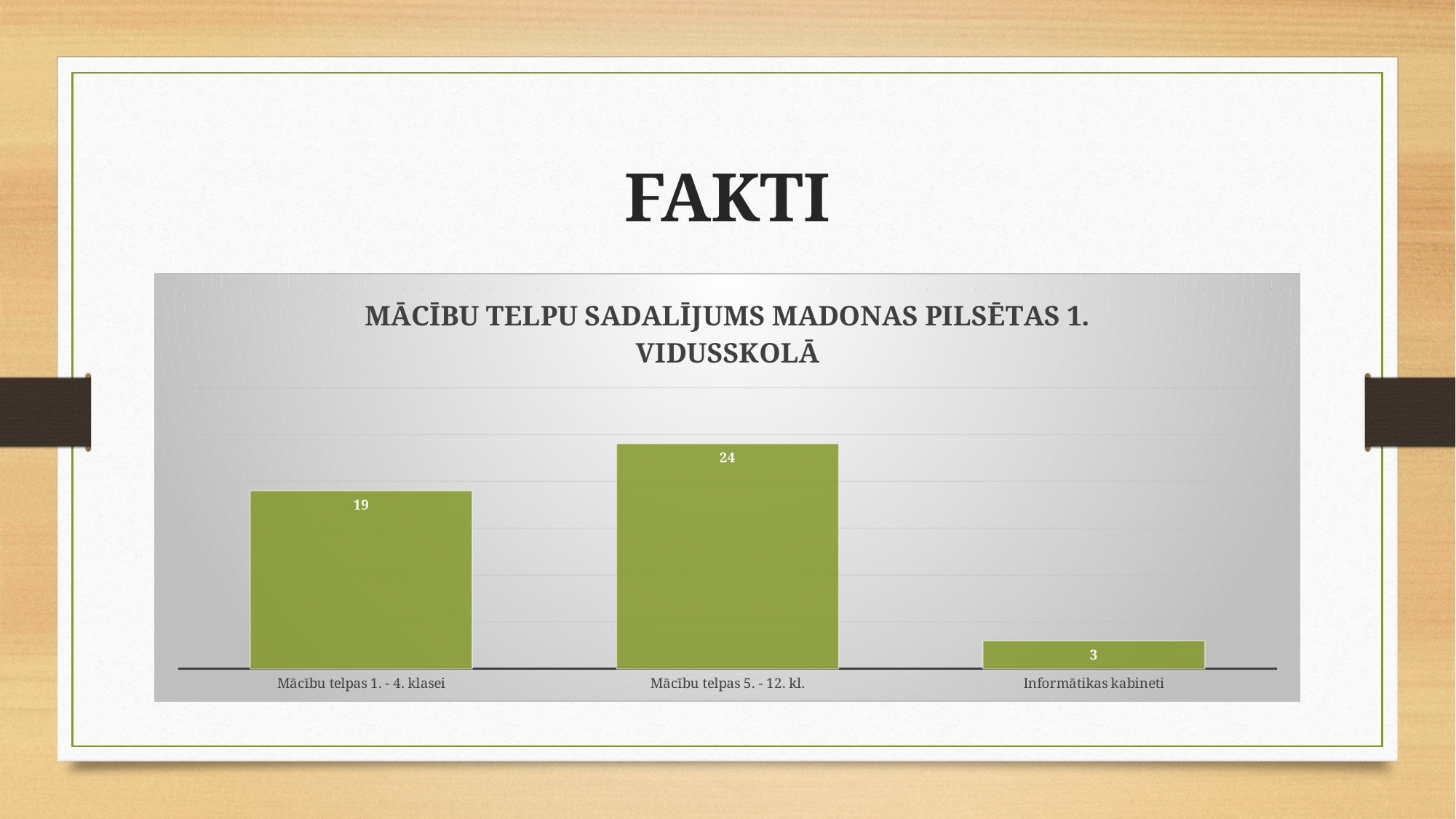
Which category has the lowest value? Informātikas kabineti What is the value for Informātikas kabineti? 3 What is the difference between the values for Mācību telpas 5. - 12. kl. and Mācību telpas 1. - 4. klasei? 5 What is the title of the chart? MĀCĪBU TELPU SADALĪJUMS MADONAS PILSĒTAS 1. VIDUSSKOLĀ How many categories are shown in the chart? 3 What colour are the bars in the chart? Green What kind of chart is shown on the slide? Bar chart Which is larger, the value for Mācību telpas 1. - 4. klasei or the value for Informātikas kabineti? Mācību telpas 1. - 4. klasei What is the value for Mācību telpas 1. - 4. klasei? 19 What is the value for Mācību telpas 5. - 12. kl.? 24 What is the difference between the values for Mācību telpas 1. - 4. klasei and Informātikas kabineti? 16 Which category has the highest value? Mācību telpas 5. - 12. kl.